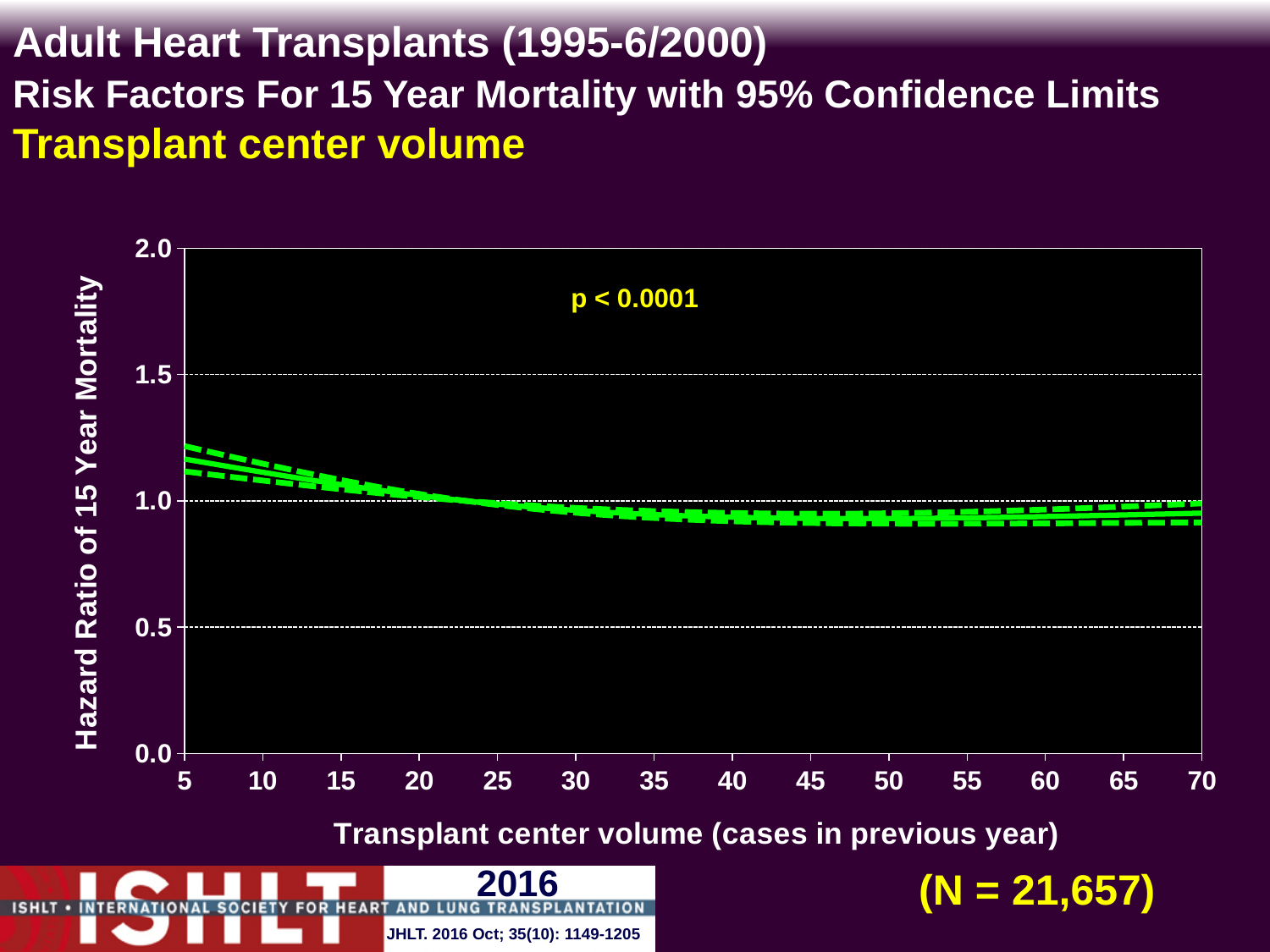
Is the hazard ratio at a volume of 5 larger or smaller than at a volume of 40? larger What is the x-axis label of the chart? Transplant center volume (cases in previous year) What is the highest value labelled on the y axis? 2.0 How many tick labels are shown on the x axis? 14 What kind of chart is shown on the slide? line chart Is the hazard ratio at a transplant center volume of 45 greater or less than 1.0? less Is the hazard ratio at a transplant center volume of 50 greater or less than 0.5? greater What p-value is printed on the chart? p < 0.0001 Is the hazard ratio at a transplant center volume of 5 greater or less than 1.0? greater Between a transplant center volume of 5 and 25, does the hazard ratio rise or fall? fall